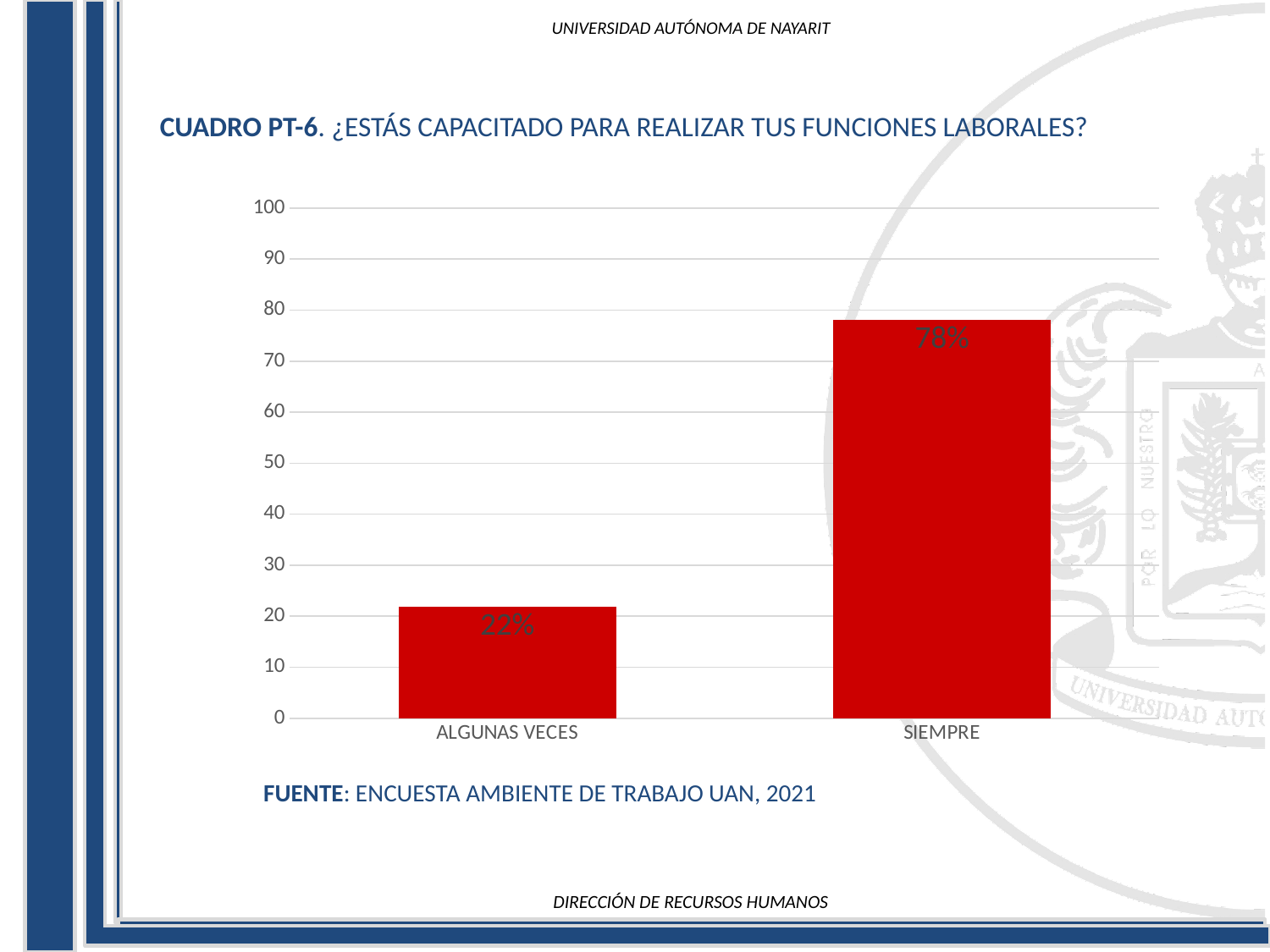
How many categories are shown on the x axis? 2 What is the value for SIEMPRE? 78% Is the value for ALGUNAS VECES greater or less than 30? less What is the difference between the values for SIEMPRE and ALGUNAS VECES? 56% What source is cited below the chart? ENCUESTA AMBIENTE DE TRABAJO UAN, 2021 Which category has the highest value? SIEMPRE Is the value for SIEMPRE greater or less than 70? greater What is the value for ALGUNAS VECES? 22% What is the total of the two values shown in the chart? 100% Which is larger, the value for ALGUNAS VECES or the value for SIEMPRE? SIEMPRE Which category has the lowest value? ALGUNAS VECES What kind of chart is shown on the slide? Bar chart